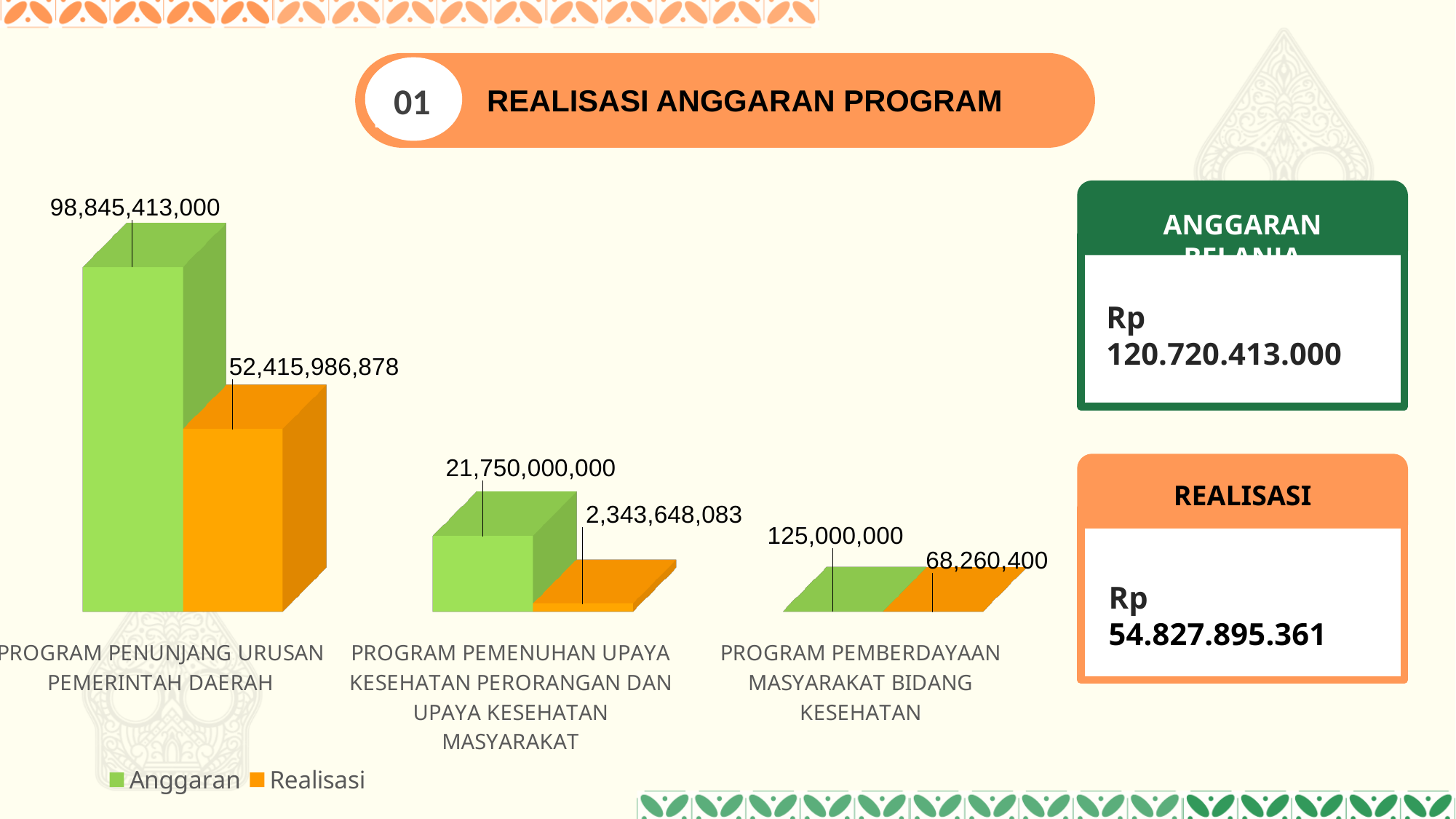
What is the Realisasi value for Program Pemberdayaan Masyarakat Bidang Kesehatan? 68,260,400 Which program has the lowest Realisasi value? Program Pemberdayaan Masyarakat Bidang Kesehatan Which is larger: the Realisasi for Program Penunjang Urusan Pemerintah Daerah or the Anggaran for Program Pemenuhan Upaya Kesehatan Perorangan dan Upaya Kesehatan Masyarakat? Realisasi for Program Penunjang Urusan Pemerintah Daerah What is the Realisasi value for Program Penunjang Urusan Pemerintah Daerah? 52,415,986,878 What is the difference between Anggaran and Realisasi for Program Penunjang Urusan Pemerintah Daerah? 46,429,426,122 How many programs (categories) are shown in the chart? 3 What type of chart is shown on the slide? Bar chart How many series does the chart legend list? 2 What is the difference between Anggaran and Realisasi for Program Pemberdayaan Masyarakat Bidang Kesehatan? 56,739,600 What is the Anggaran value for Program Pemenuhan Upaya Kesehatan Perorangan dan Upaya Kesehatan Masyarakat? 21,750,000,000 Which program has the highest Anggaran value? Program Penunjang Urusan Pemerintah Daerah What is the Anggaran value for Program Penunjang Urusan Pemerintah Daerah? 98,845,413,000